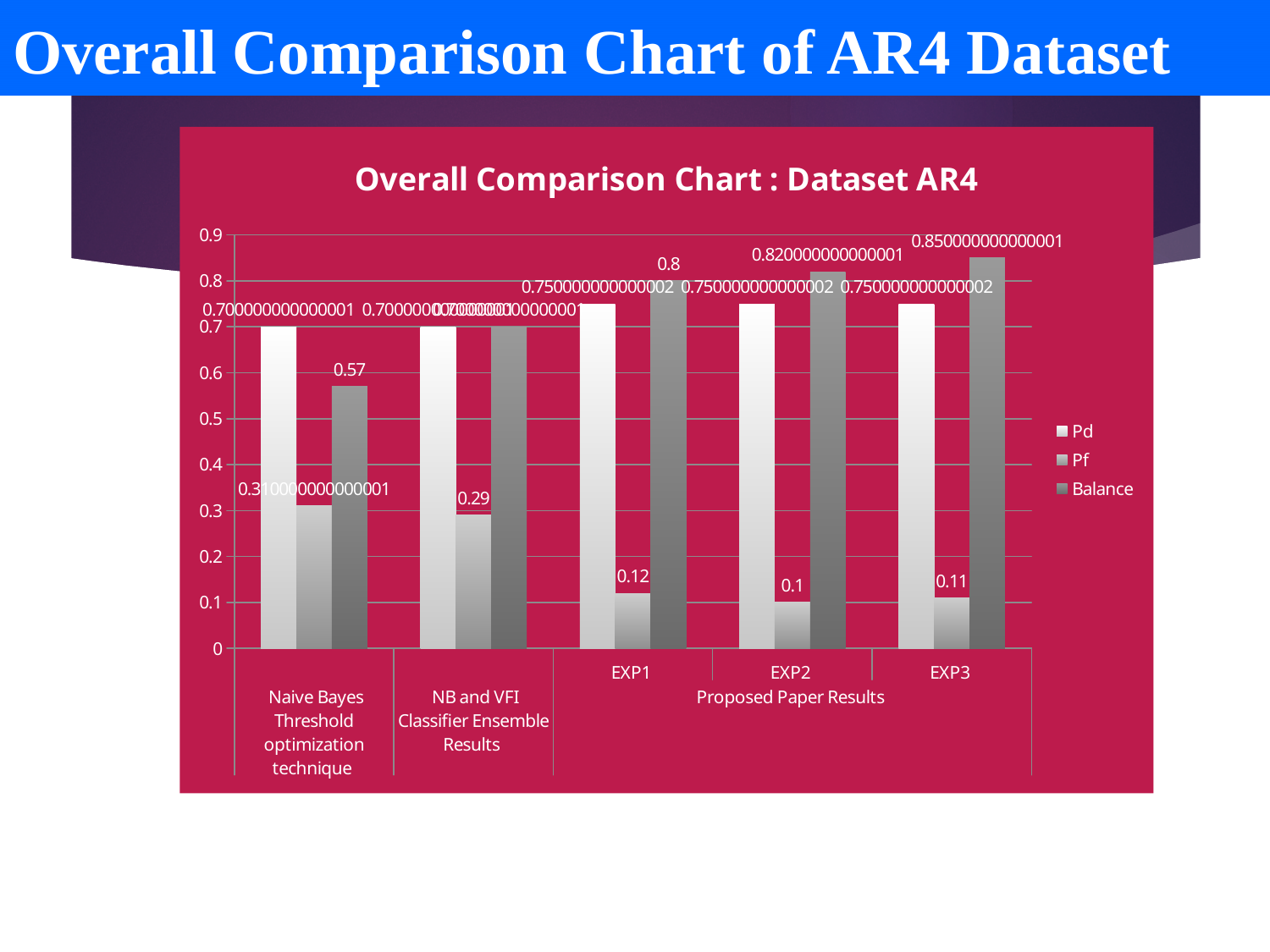
How many series does the legend list? 3 What is the difference between the Pf value for EXP1 and the Pf value for EXP3? 0.01 Do the Balance values rise or fall from EXP1 to EXP3? Rise Which category has the highest Balance value? EXP3 What is the title of the chart? Overall Comparison Chart : Dataset AR4 What kind of chart is shown? Bar chart Which category has the lowest Pf value? EXP2 What is the Pf value for EXP2? 0.1 What is the Pf value for EXP1? 0.12 What is the Balance value for EXP1? 0.8 What is the Balance value for the Naive Bayes Threshold optimization technique? 0.57 What is the Pf value for NB and VFI Classifier Ensemble Results? 0.29